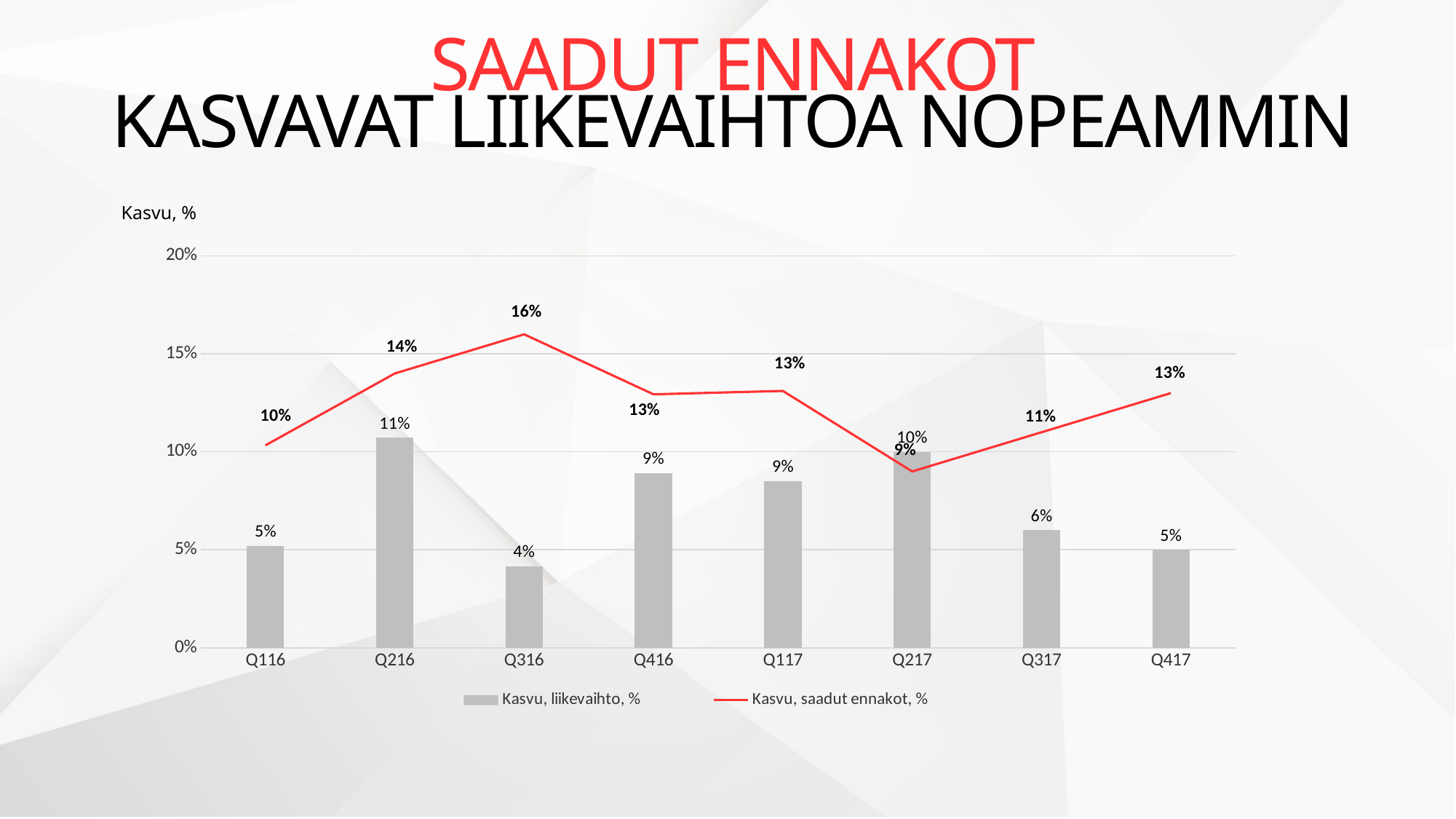
What is the value of Kasvu, liikevaihto, % for Q317? 6% What is the value of Kasvu, liikevaihto, % for Q216? 11% Which quarter has the lowest value for Kasvu, liikevaihto, %? Q316 Does Kasvu, saadut ennakot, % rise or fall from Q217 to Q417? Rise Which is larger in Q217: Kasvu, liikevaihto, % or Kasvu, saadut ennakot, %? Kasvu, liikevaihto, % What is the difference between Kasvu, saadut ennakot, % and Kasvu, liikevaihto, % in Q316? 12% What is the value of Kasvu, saadut ennakot, % for Q316? 16% What kind of chart is shown on the slide? Combined bar and line chart How many series does the legend list? 2 Which quarter has the highest value for Kasvu, saadut ennakot, %? Q316 How many quarters are shown on the x axis? 8 What is the label of the vertical axis? Kasvu, %